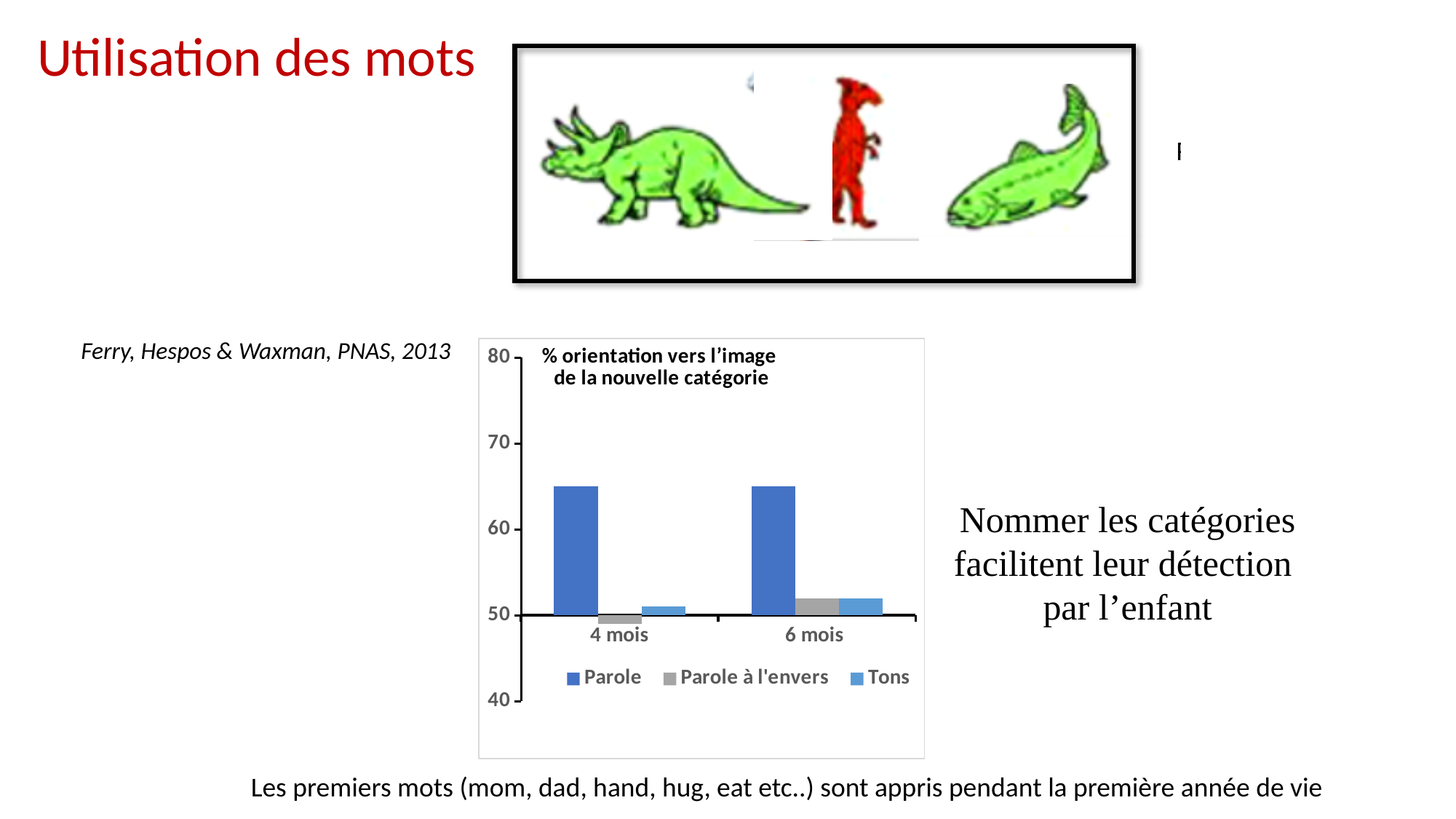
What is the title printed inside the chart? % orientation vers l'image de la nouvelle catégorie Is the value for Parole at 6 mois greater or less than 70? less Is the value for Tons at 4 mois greater or less than 60? less At 4 mois, which is larger: the value for Parole or the value for Tons? Parole Is the value for Parole at 4 mois greater or less than 60? greater How many age groups are shown on the x axis of the chart? 2 How many series does the chart legend list? 3 Which series has the highest value at 4 mois? Parole At 6 mois, which is larger: the value for Parole à l'envers or the value for Parole? Parole Which series has the highest value at 6 mois? Parole Which series does the legend list first? Parole What kind of chart is shown on the slide? bar chart